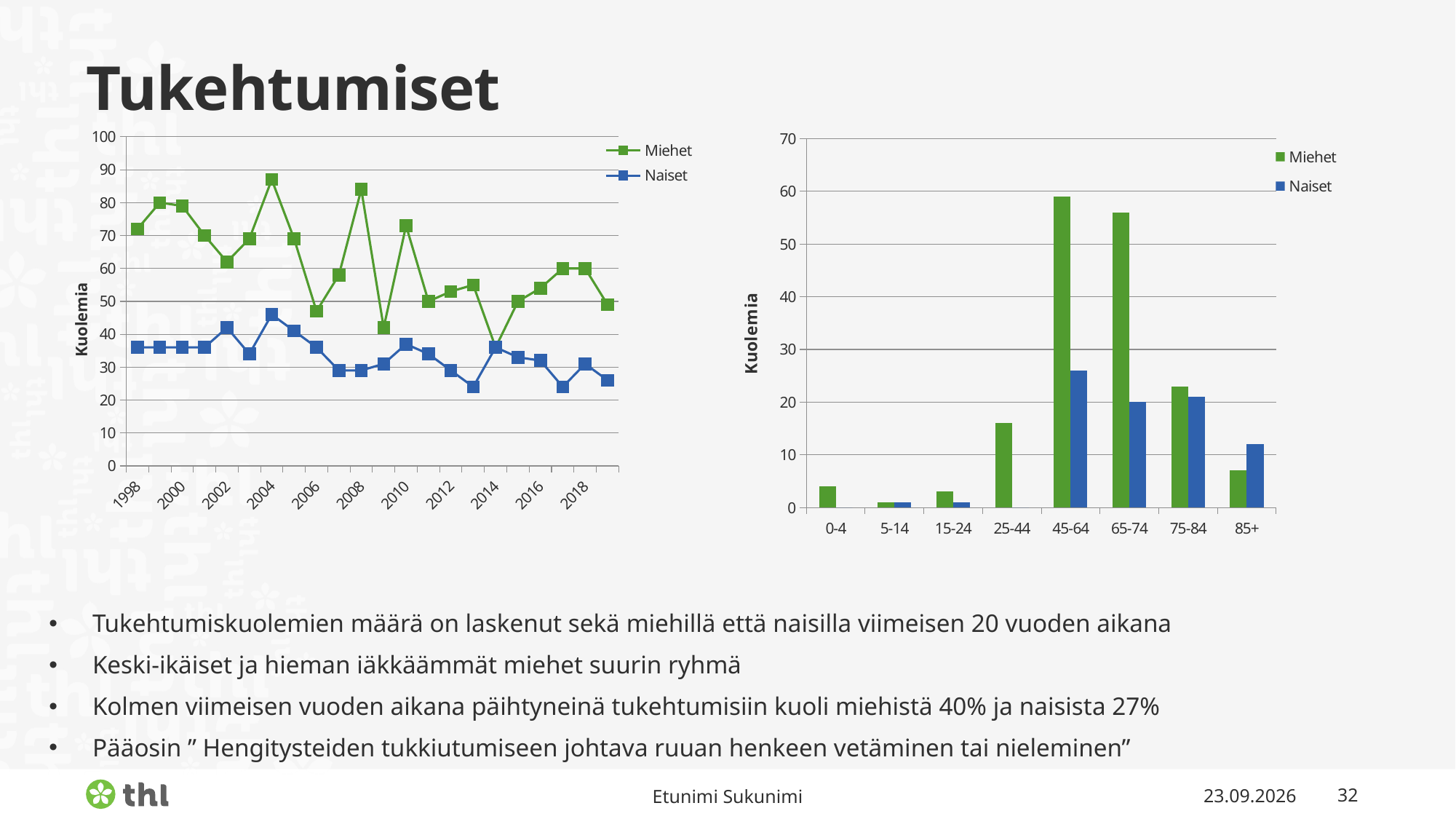
In the left-hand chart, in which year does the Naiset series reach its highest value? 2004 In the left-hand chart, is the value for Miehet in 2004 greater or less than 80? greater In the right-hand chart, which is larger for the 85+ age group, Miehet or Naiset? Naiset How many age-group categories are shown on the x axis of the right-hand chart? 8 In the right-hand chart, is the value for Naiset in the 85+ age group greater or less than 10? greater In the right-hand chart, is the value for Miehet in the 25-44 age group greater or less than 10? greater In the left-hand chart, does the Miehet series generally rise or fall from 1998 to 2019? fall In the right-hand chart, which age group has the highest value for Naiset? 45-64 What kind of chart is the chart on the left of the slide? line chart How many series does the legend of the right-hand chart list? 2 In the right-hand chart, which age group has the highest value for Miehet? 45-64 What kind of chart is the chart on the right of the slide? bar chart